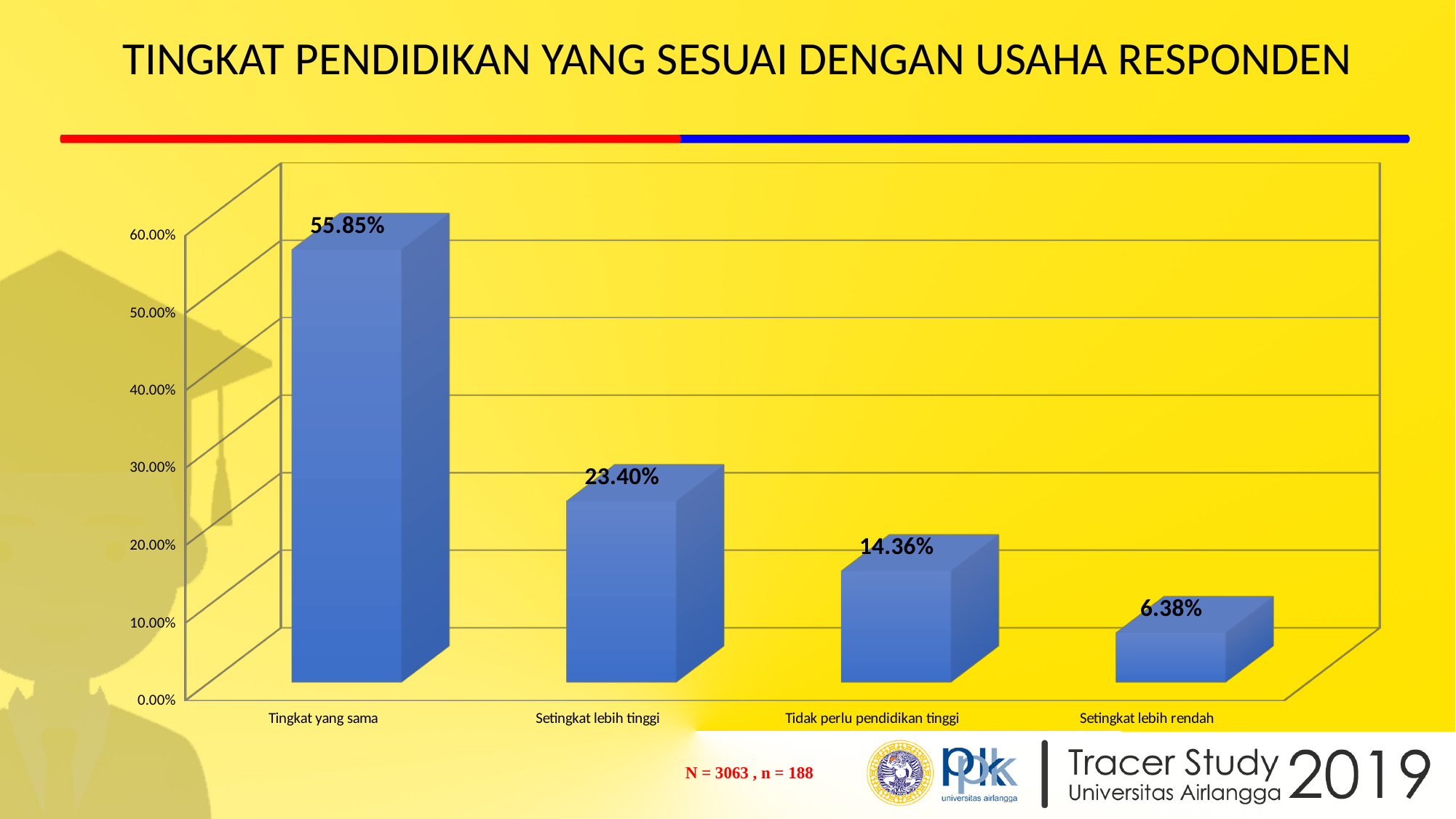
What is the value for Tingkat yang sama? 55.85% What is the difference between the values for Tingkat yang sama and Setingkat lebih tinggi? 32.45% What kind of chart is shown on the slide? Bar chart Which category has the highest value? Tingkat yang sama What is the value for Setingkat lebih rendah? 6.38% What is the difference between the values for Tidak perlu pendidikan tinggi and Setingkat lebih rendah? 7.98% What is the value for Tidak perlu pendidikan tinggi? 14.36% Which category has the lowest value? Setingkat lebih rendah How many categories are shown on the chart? 4 What is the value for Setingkat lebih tinggi? 23.40% Do the values rise or fall from left to right along the x axis? Fall Which is larger, the value for Setingkat lebih tinggi or the value for Tidak perlu pendidikan tinggi? Setingkat lebih tinggi